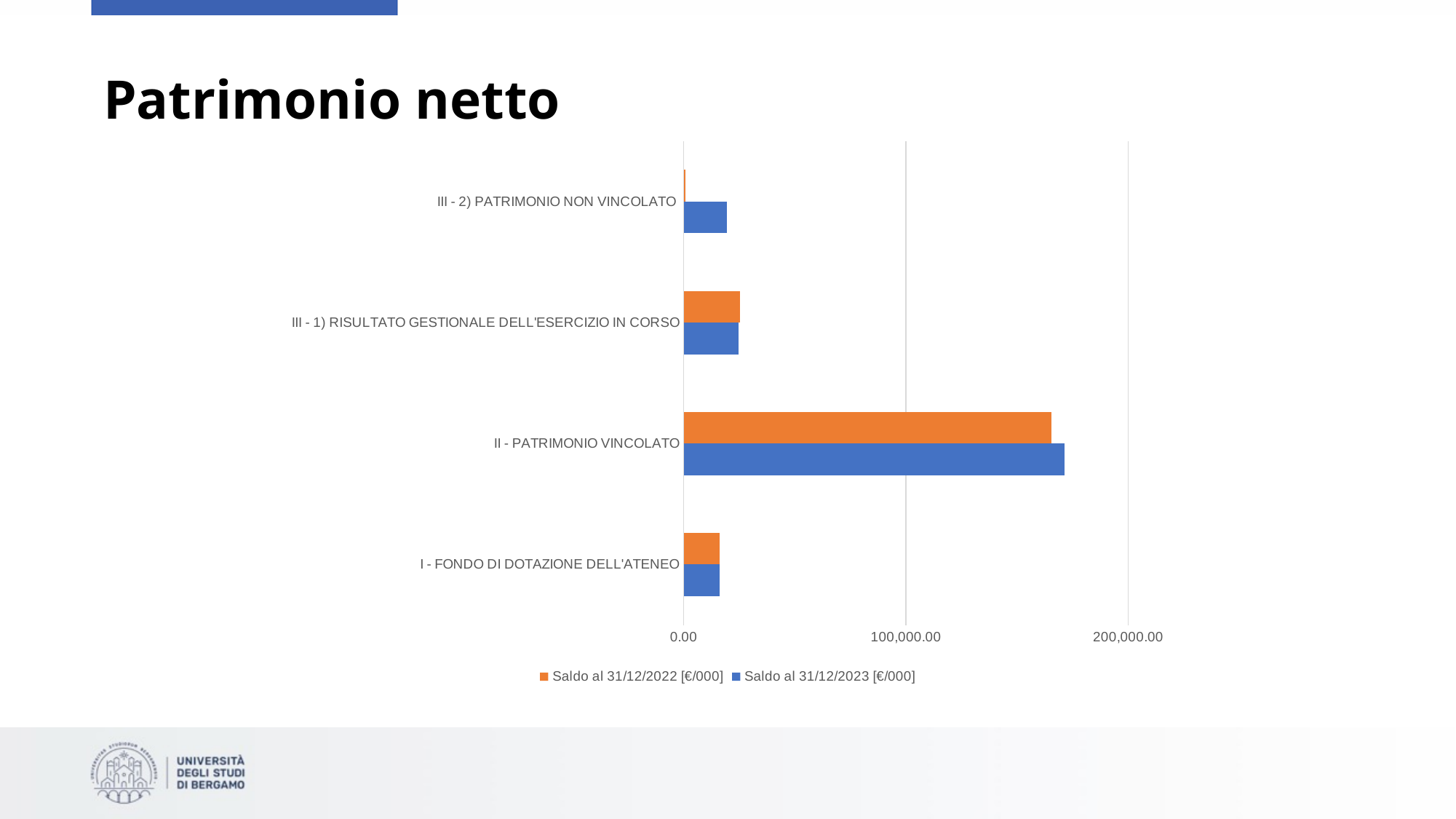
What kind of chart is shown on the slide? bar chart Is the value for II - PATRIMONIO VINCOLATO in Saldo al 31/12/2022 [€/000] greater or less than 200,000.00? less What is the title of the slide containing the chart? Patrimonio netto Is the value for II - PATRIMONIO VINCOLATO in Saldo al 31/12/2023 [€/000] greater or less than 100,000.00? greater Which series is shown in orange? Saldo al 31/12/2022 [€/000] How many categories are shown on the chart? 4 Which category has the lowest value for Saldo al 31/12/2022 [€/000]? III - 2) PATRIMONIO NON VINCOLATO Which category has the highest value for Saldo al 31/12/2022 [€/000]? II - PATRIMONIO VINCOLATO How many series does the legend list? 2 Which category has the highest value for Saldo al 31/12/2023 [€/000]? II - PATRIMONIO VINCOLATO For III - 2) PATRIMONIO NON VINCOLATO, which series has the larger value: Saldo al 31/12/2022 [€/000] or Saldo al 31/12/2023 [€/000]? Saldo al 31/12/2023 [€/000] Is the value for I - FONDO DI DOTAZIONE DELL'ATENEO in Saldo al 31/12/2022 [€/000] greater or less than 100,000.00? less